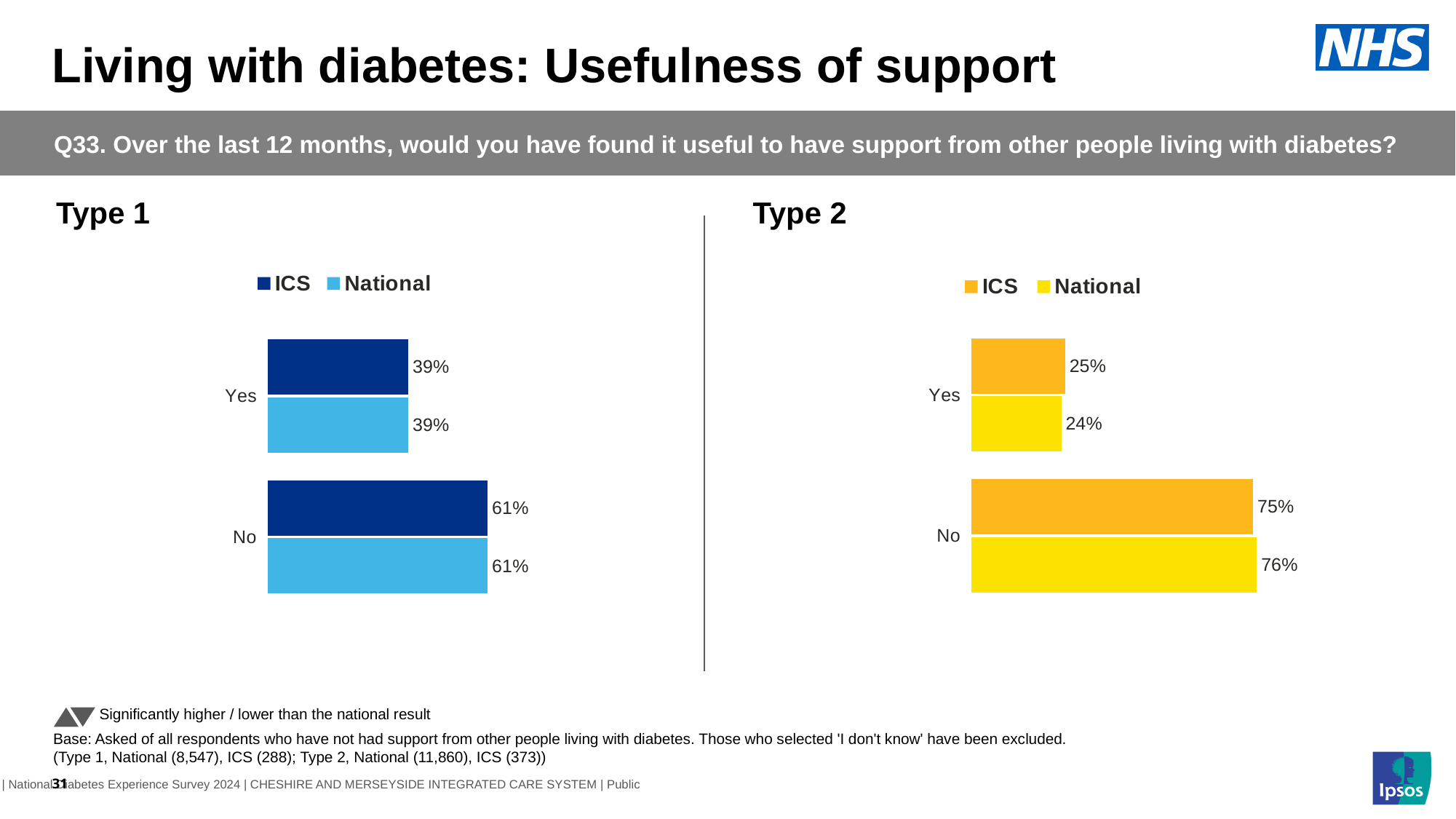
In the Type 1 chart, what is the National value for No? 61% In the Type 1 chart, which category has the lowest National value? Yes In the Type 1 chart, what is the difference between the No and Yes values for ICS? 22% In the Type 1 chart, what is the ICS value for Yes? 39% What kind of chart is the Type 1 chart? Bar chart In the Type 2 chart, what is the difference between the ICS and National values for No? 1% In the Type 2 chart, what is the National value for No? 76% In the Type 2 chart, what is the ICS value for Yes? 25% In the Type 1 chart, how many categories are shown? 2 In the Type 2 chart, what is the National value for Yes? 24% In the Type 2 chart, which category has the highest ICS value? No In the Type 2 chart, how many series does the legend list? 2